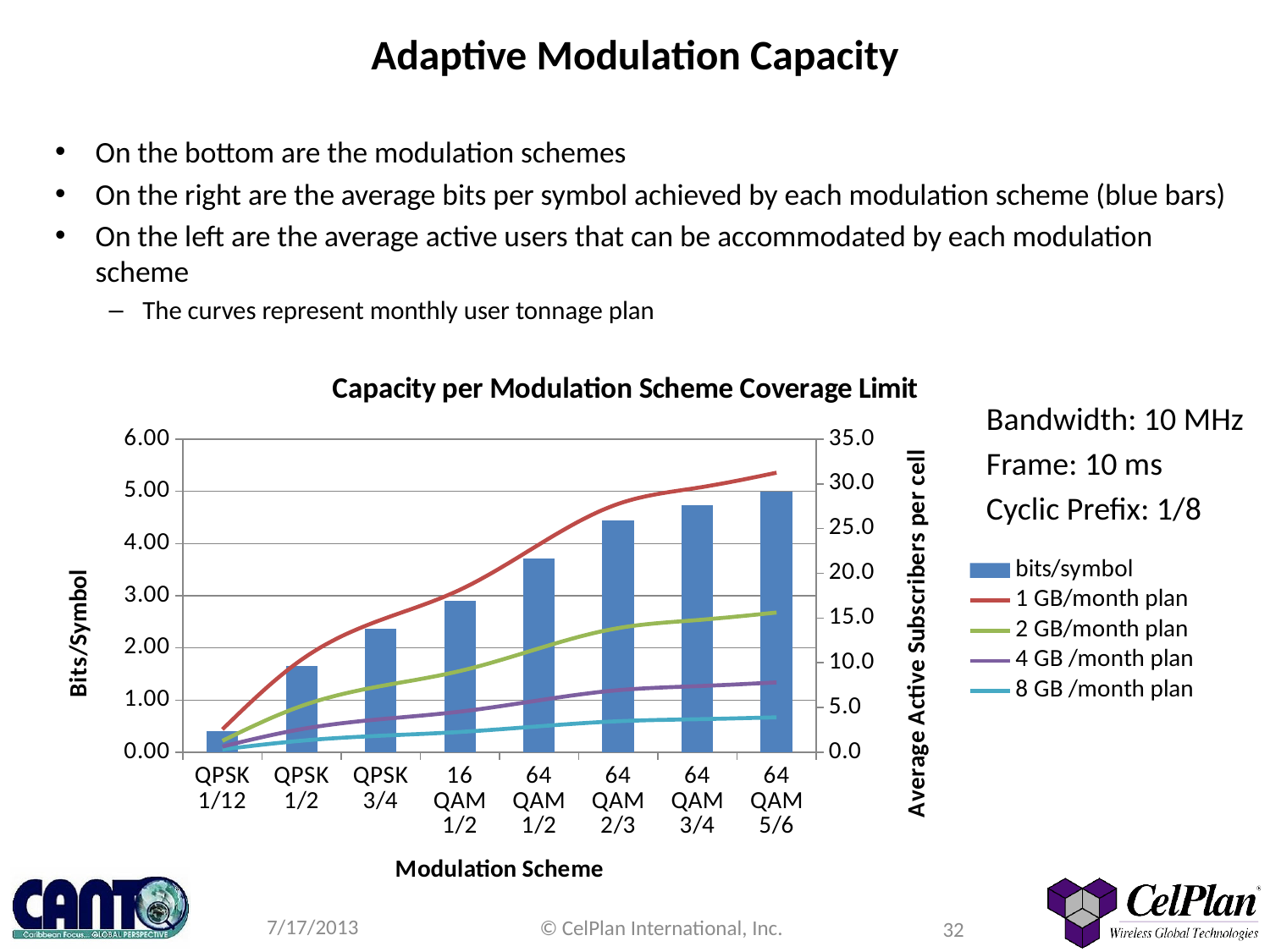
Is the bits/symbol value for 64 QAM 1/2 greater or less than 3.00? greater Is the bits/symbol value for QPSK 1/12 greater or less than 1.00? less How many series does the chart legend list? 5 Is the bits/symbol value for 64 QAM 5/6 greater or less than 4.00? greater What is the title of the chart? Capacity per Modulation Scheme Coverage Limit Which modulation scheme has the highest bits/symbol bar? 64 QAM 5/6 Which has a higher bits/symbol bar, QPSK 3/4 or 64 QAM 3/4? 64 QAM 3/4 How many modulation schemes are shown on the x axis of the chart? 8 Which modulation scheme has the lowest bits/symbol bar? QPSK 1/12 Which monthly plan curve lies highest on the chart? 1 GB/month plan Do the bits/symbol bars rise or fall from QPSK 1/12 to 64 QAM 5/6? rise